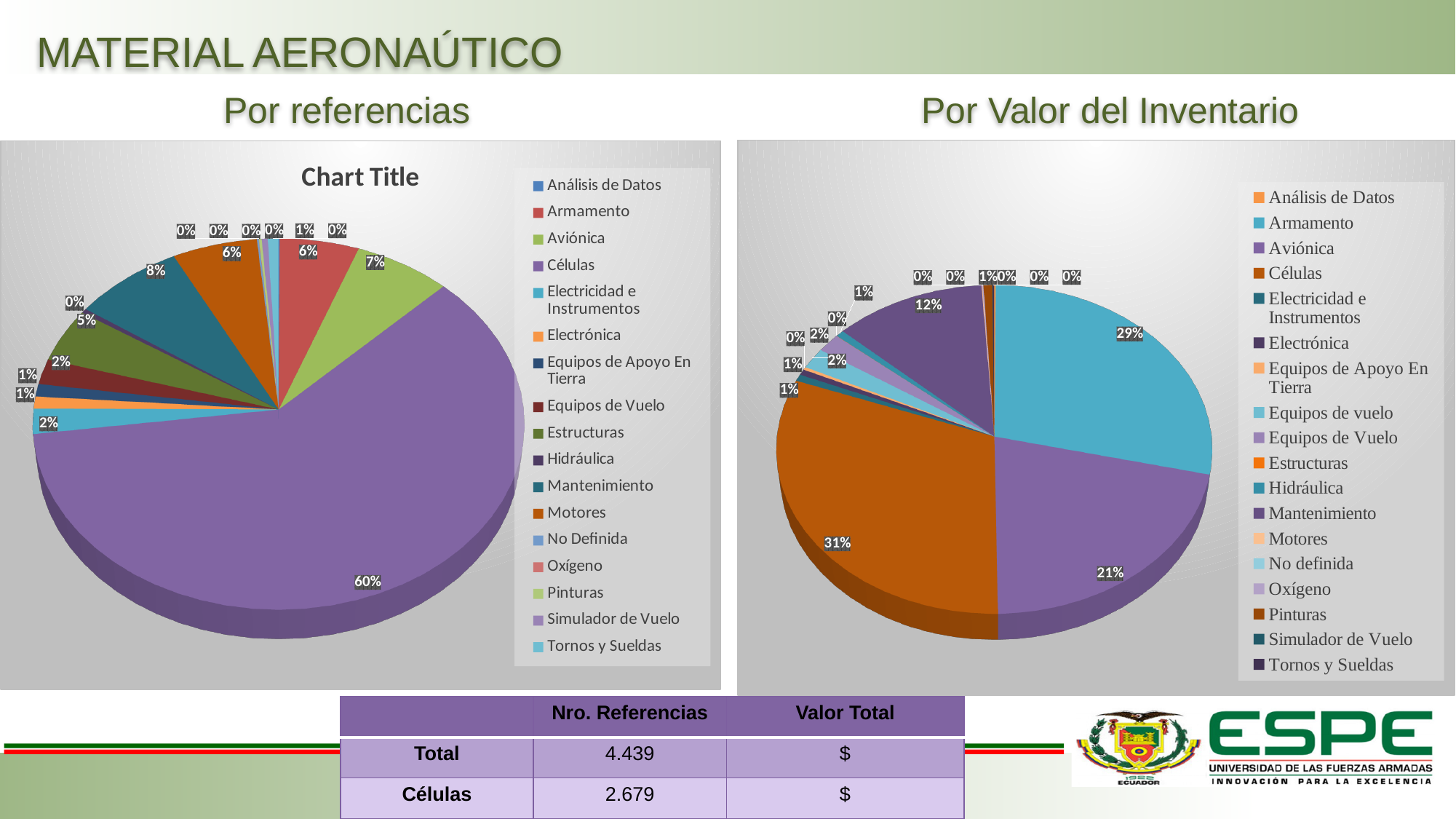
On the 'Por Valor del Inventario' chart, which category has the largest slice? Células On the 'Por Valor del Inventario' chart, which is larger, the Armamento slice or the Aviónica slice? Armamento On the 'Por Valor del Inventario' chart, what share does Armamento have? 29% On the 'Por referencias' chart, what share does Mantenimiento have? 8% What type of chart is used on the 'Por referencias' side of the slide? Pie chart On the 'Por Valor del Inventario' chart, what is the difference between the Células share and the Aviónica share? 10% What is the title shown above the left pie chart? Chart Title On the 'Por Valor del Inventario' chart, what share does Aviónica have? 21% On the 'Por referencias' chart, which category has the largest slice? Células How many categories does the legend of the 'Por referencias' chart list? 17